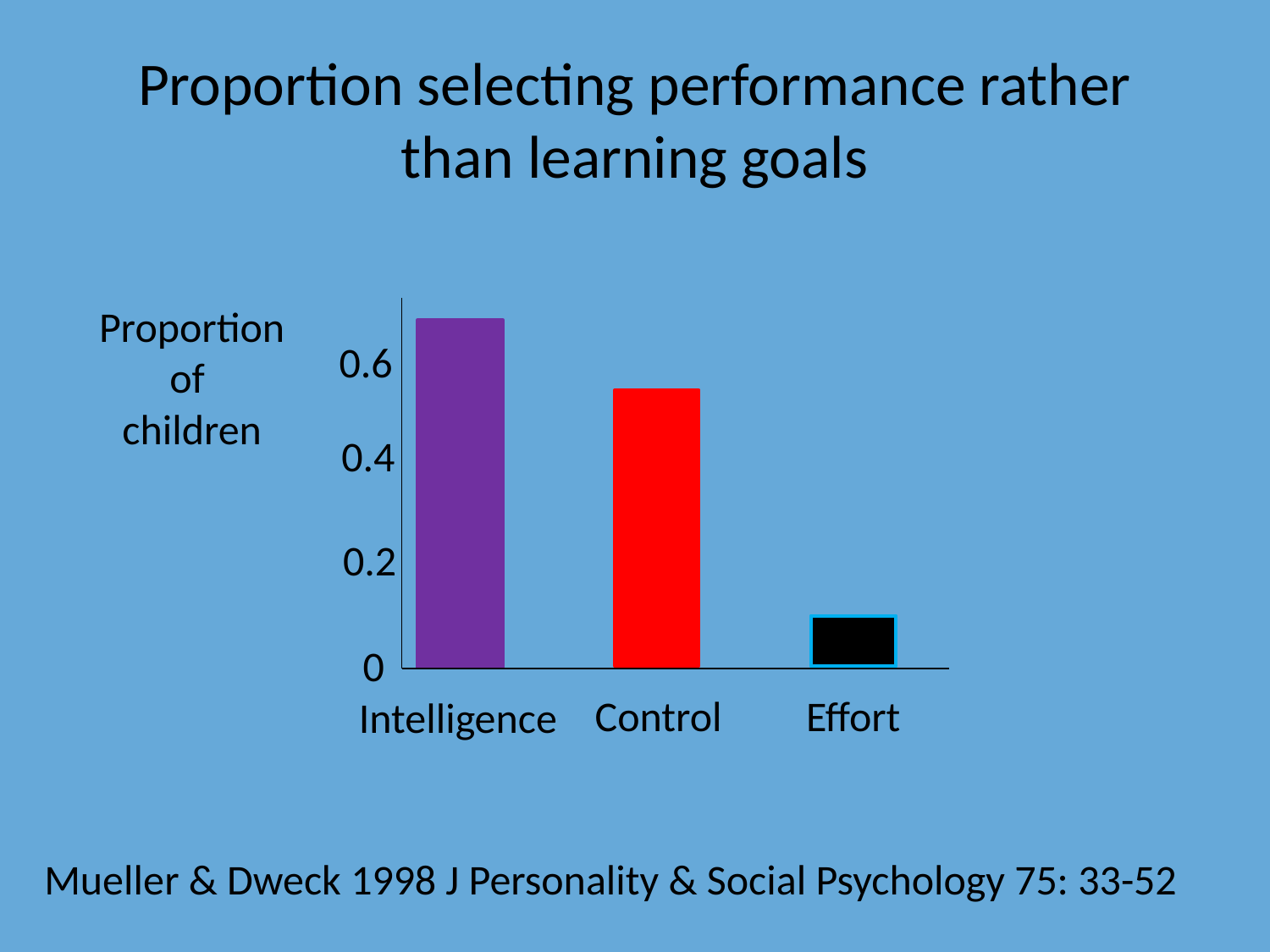
Do the values rise or fall moving from Intelligence to Effort along the x axis? fall Which category has the lowest proportion of children? Effort Is the value for Control greater or less than 0.4? greater Which is larger, the value for Intelligence or the value for Control? Intelligence Is the value for Effort greater or less than 0.2? less Which category has the highest proportion of children? Intelligence Which is larger, the value for Control or the value for Effort? Control What kind of chart is shown on the slide? bar chart What is the label on the vertical axis of the chart? Proportion of children Is the value for Intelligence greater or less than 0.6? greater How many categories are shown on the x axis of the chart? 3